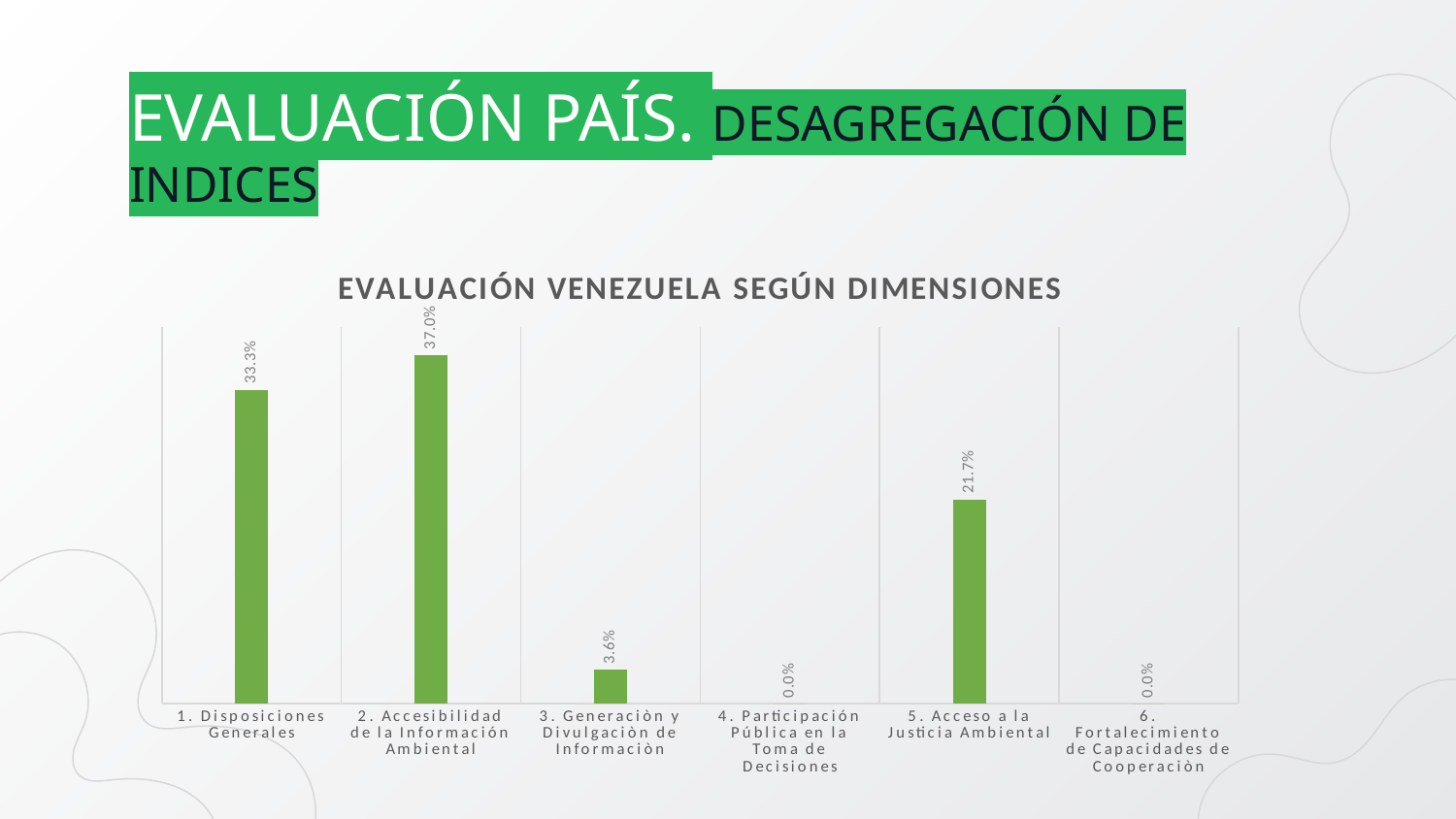
What is the difference between the values for '2. Accesibilidad de la Información Ambiental' and '1. Disposiciones Generales'? 3.7% What is the value for '1. Disposiciones Generales'? 33.3% How many dimensions have a value of 0.0%? 2 What kind of chart is shown on the slide? Bar chart What is the difference between the values for '5. Acceso a la Justicia Ambiental' and '3. Generaciòn y Divulgaciòn de Informaciòn'? 18.1% What is the value for '3. Generaciòn y Divulgaciòn de Informaciòn'? 3.6% How many dimensions (categories) are shown on the x axis? 6 Which dimension has the highest value? 2. Accesibilidad de la Información Ambiental Which is larger, the value for '1. Disposiciones Generales' or for '5. Acceso a la Justicia Ambiental'? 1. Disposiciones Generales What is the value for '2. Accesibilidad de la Información Ambiental'? 37.0% What is the value for '5. Acceso a la Justicia Ambiental'? 21.7% What is the title of the chart? EVALUACIÓN VENEZUELA SEGÚN DIMENSIONES